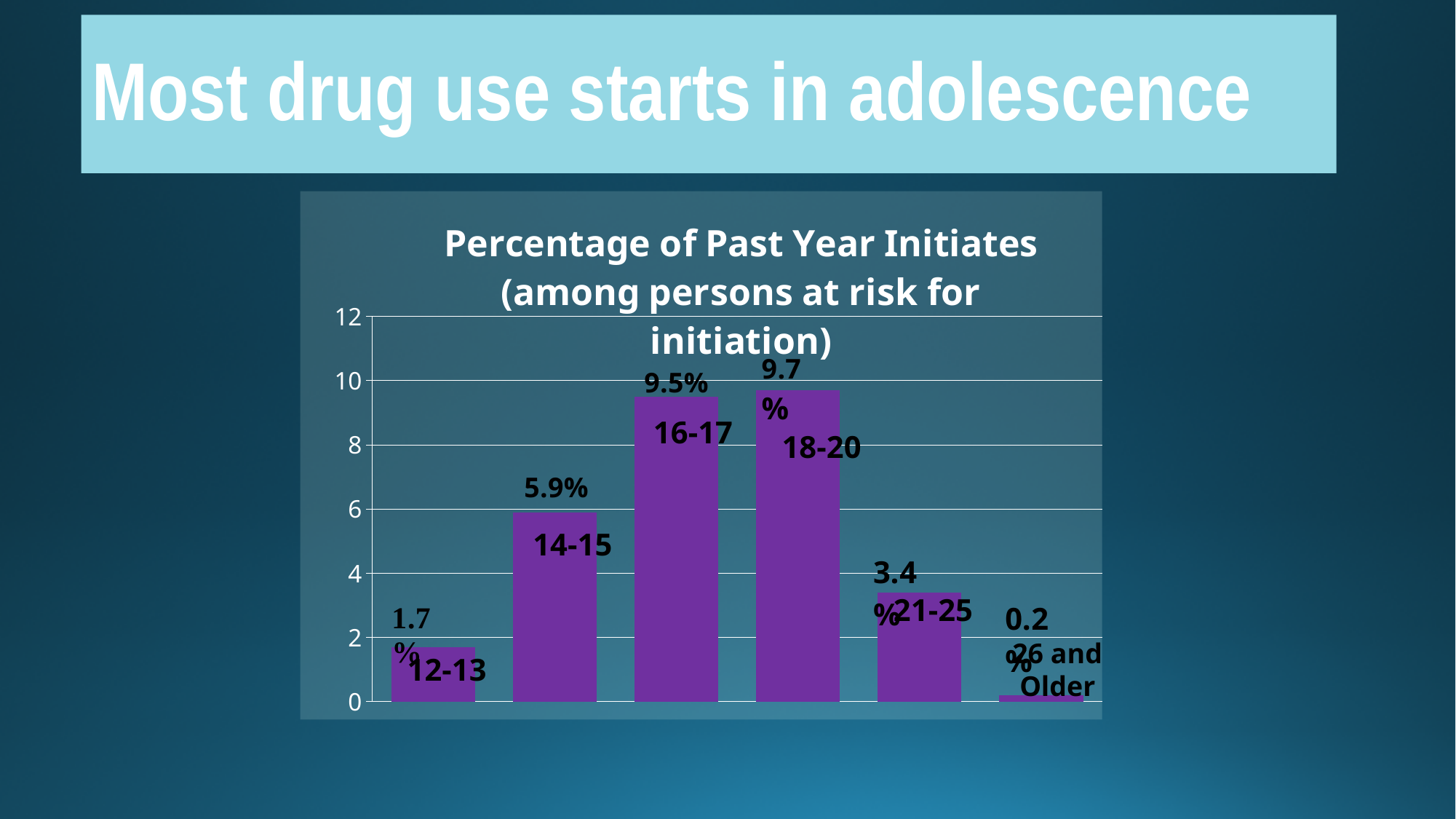
What is the difference between the percentages for the 16-17 and 14-15 age groups? 3.6% Which age group has the highest percentage of past year initiates? 18-20 Which age group has a larger percentage of past year initiates, 14-15 or 21-25? 14-15 What is the percentage of past year initiates for the 12-13 age group? 1.7% Is the value for the 16-17 age group greater or less than 8? greater What is the percentage of past year initiates for the 26 and Older age group? 0.2% How many age groups are shown in the chart? 6 What is the percentage of past year initiates for the 21-25 age group? 3.4% What is the title of the chart? Percentage of Past Year Initiates (among persons at risk for initiation) What is the percentage of past year initiates for the 14-15 age group? 5.9% Which age group has the lowest percentage of past year initiates? 26 and Older What type of chart is shown on the slide? bar chart